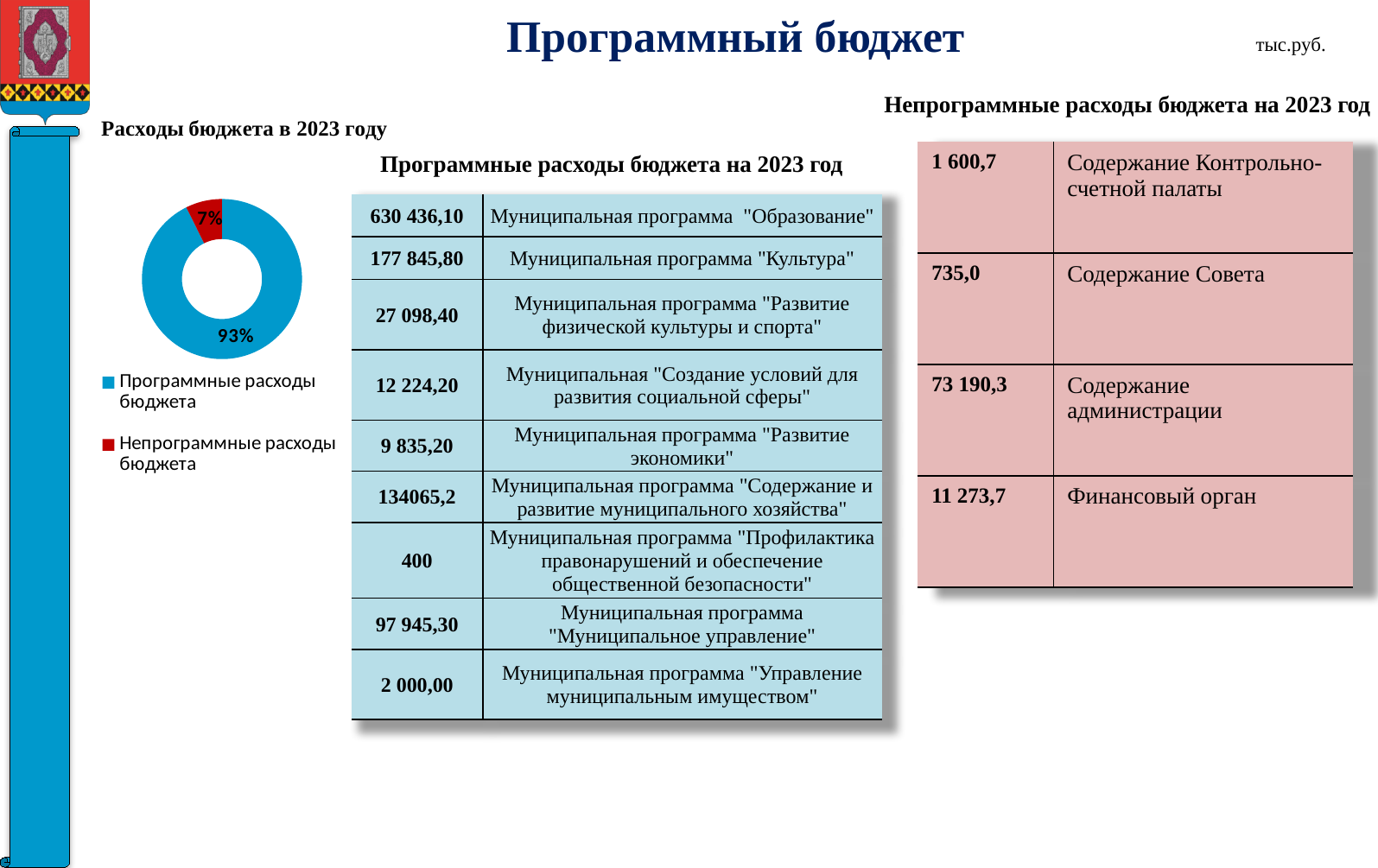
In the pie chart 'Расходы бюджета в 2023 году', which category has the smallest share? Непрограммные расходы бюджета In the pie chart 'Расходы бюджета в 2023 году', is the share of 'Программные расходы бюджета' greater or less than 50%? greater What kind of chart is 'Расходы бюджета в 2023 году'? Pie chart (doughnut) In the pie chart 'Расходы бюджета в 2023 году', what colour is the slice for 'Программные расходы бюджета'? Blue What share of the pie chart 'Расходы бюджета в 2023 году' is 'Непрограммные расходы бюджета'? 7% How many entries does the legend of the pie chart 'Расходы бюджета в 2023 году' list? 2 What share of the pie chart 'Расходы бюджета в 2023 году' is 'Программные расходы бюджета'? 93% In the pie chart 'Расходы бюджета в 2023 году', which is larger: 'Программные расходы бюджета' or 'Непрограммные расходы бюджета'? Программные расходы бюджета In the pie chart 'Расходы бюджета в 2023 году', which category has the largest share? Программные расходы бюджета In the pie chart 'Расходы бюджета в 2023 году', what colour is the slice for 'Непрограммные расходы бюджета'? Red How many categories does the pie chart 'Расходы бюджета в 2023 году' show? 2 In the pie chart 'Расходы бюджета в 2023 году', what is the difference in percentage points between 'Программные расходы бюджета' and 'Непрограммные расходы бюджета'? 86 percentage points